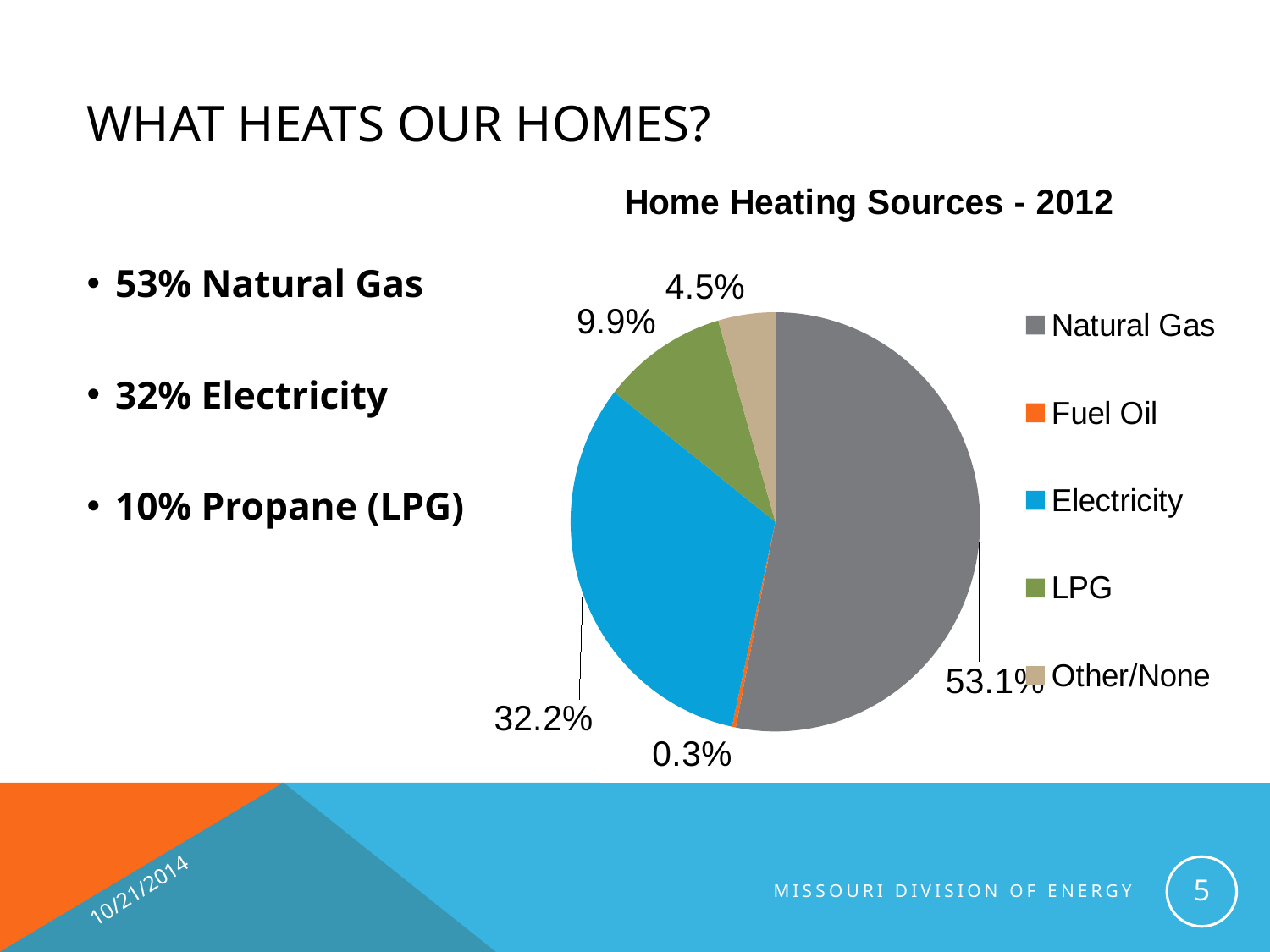
How many categories does the legend list? 5 What is the title of the chart? Home Heating Sources - 2012 What is the value for Electricity? 32.2% What share of the pie does Natural Gas have? 53.1% What is the difference between the Natural Gas and Electricity shares? 20.9% What is the value for Other/None? 4.5% What is the value for LPG? 9.9% Which heating source has the largest slice of the pie? Natural Gas Which heating source has the smallest slice of the pie? Fuel Oil Which is larger, the LPG slice or the Other/None slice? LPG What is the value for Fuel Oil? 0.3% What kind of chart is shown on the slide? pie chart